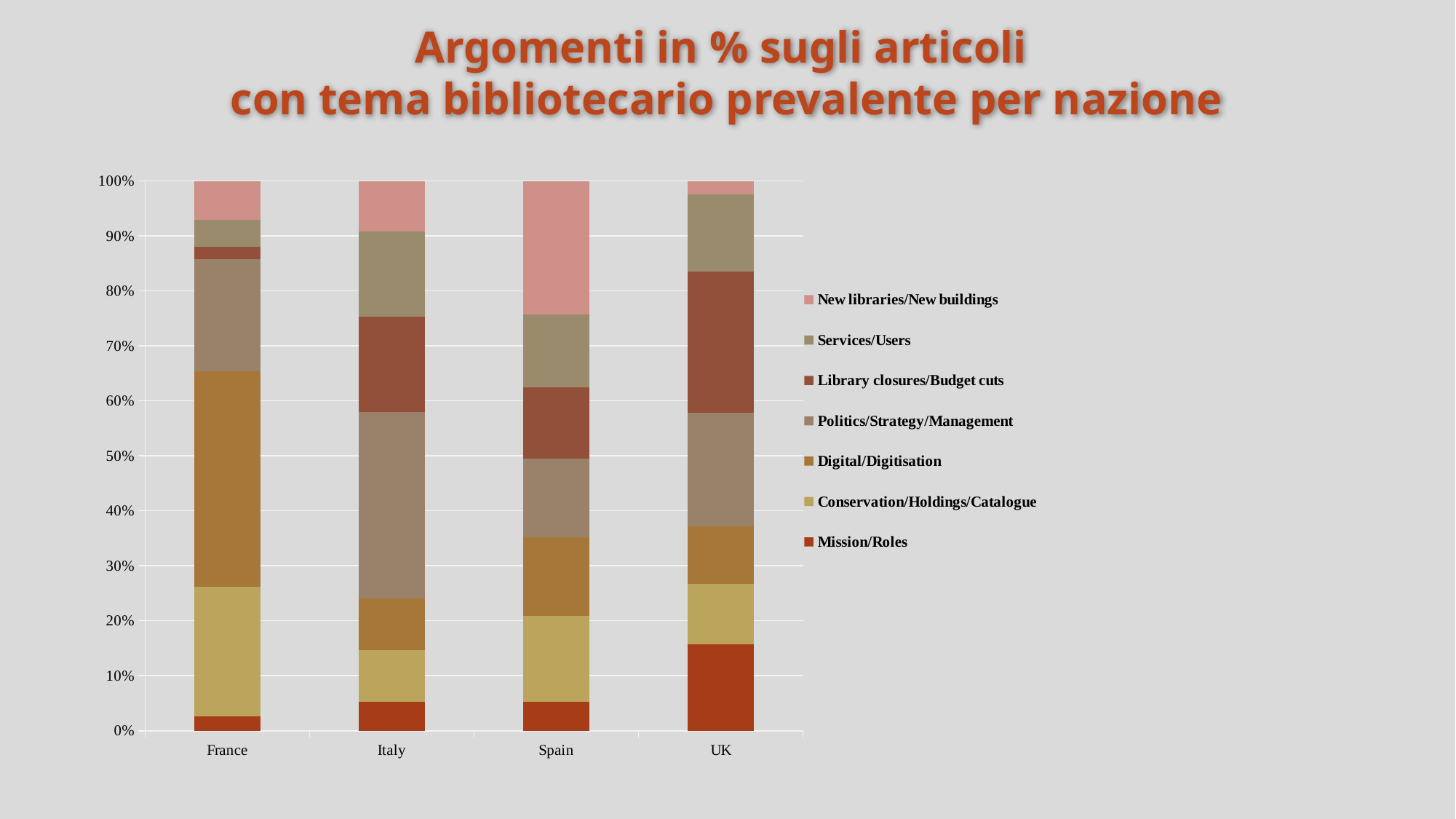
Is the Mission/Roles segment larger for the UK or for Italy? UK Which country has the largest Digital/Digitisation segment? France What is the total of each stacked bar? 100% What kind of chart is shown on the slide? stacked bar chart How many series does the legend list? 7 Which series is listed first (at the top) in the legend? New libraries/New buildings Is the Digital/Digitisation value for France greater or less than 30%? greater Is the Mission/Roles value for the UK greater or less than 10%? greater How many countries are shown on the x axis? 4 Which country has the smallest Mission/Roles segment? France Which country has the largest New libraries/New buildings segment? Spain Which country has the largest Library closures/Budget cuts segment? UK